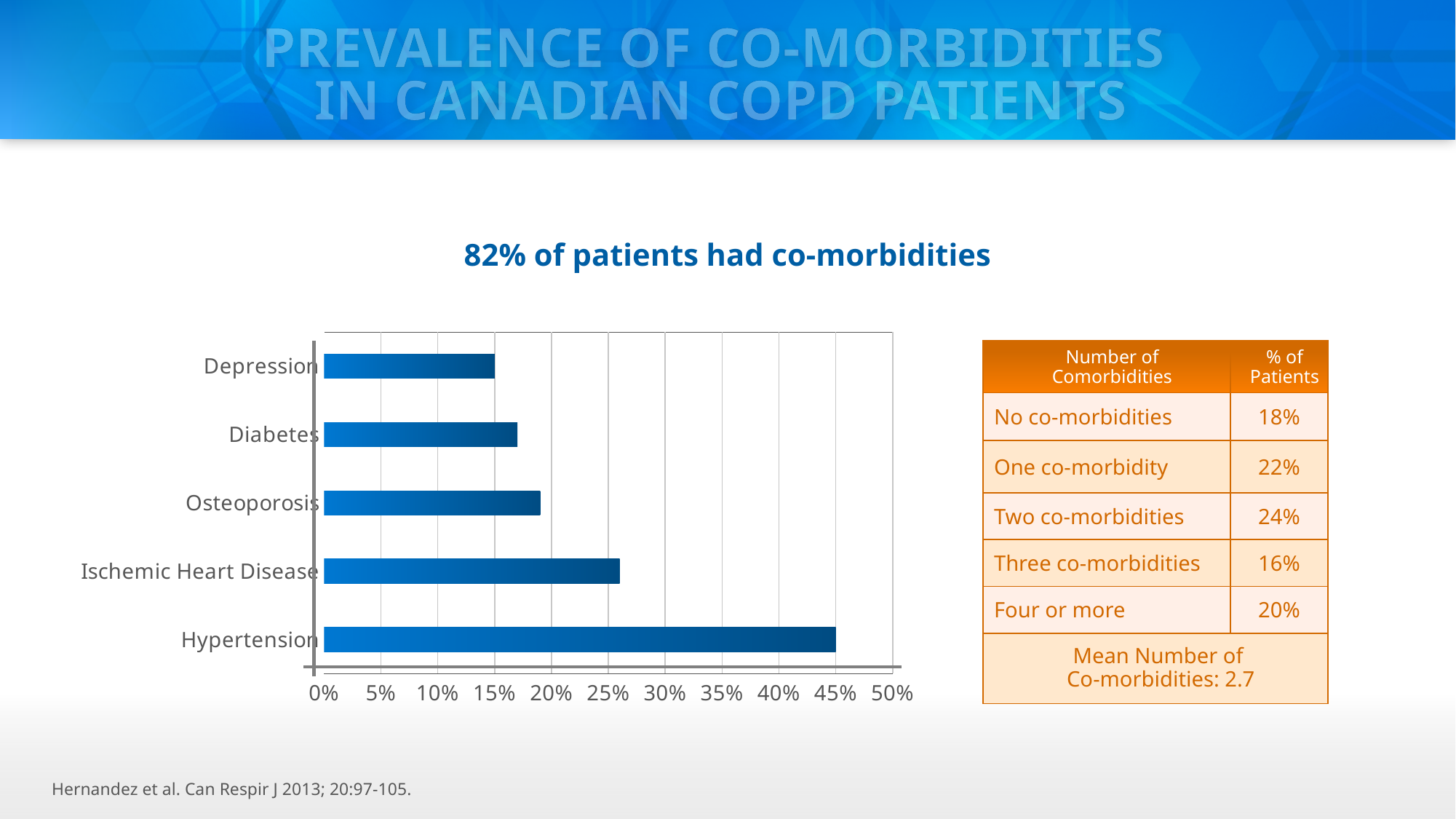
What is the maximum value shown on the x axis of the bar chart? 50% Which co-morbidity has the highest prevalence in the bar chart? Hypertension What is the prevalence of Depression shown in the bar chart? 15% Is the value for Osteoporosis greater or less than 20%? less Is the value for Diabetes greater or less than 15%? greater What is the prevalence of Hypertension shown in the bar chart? 45% What kind of chart is shown on the slide? bar chart Which co-morbidity has the lowest prevalence in the bar chart? Depression How many co-morbidity categories are plotted in the bar chart? 5 Is the value for Ischemic Heart Disease greater or less than 25%? greater Which has a higher prevalence, Ischemic Heart Disease or Osteoporosis? Ischemic Heart Disease What is the difference between the prevalence of Hypertension and Depression? 30%